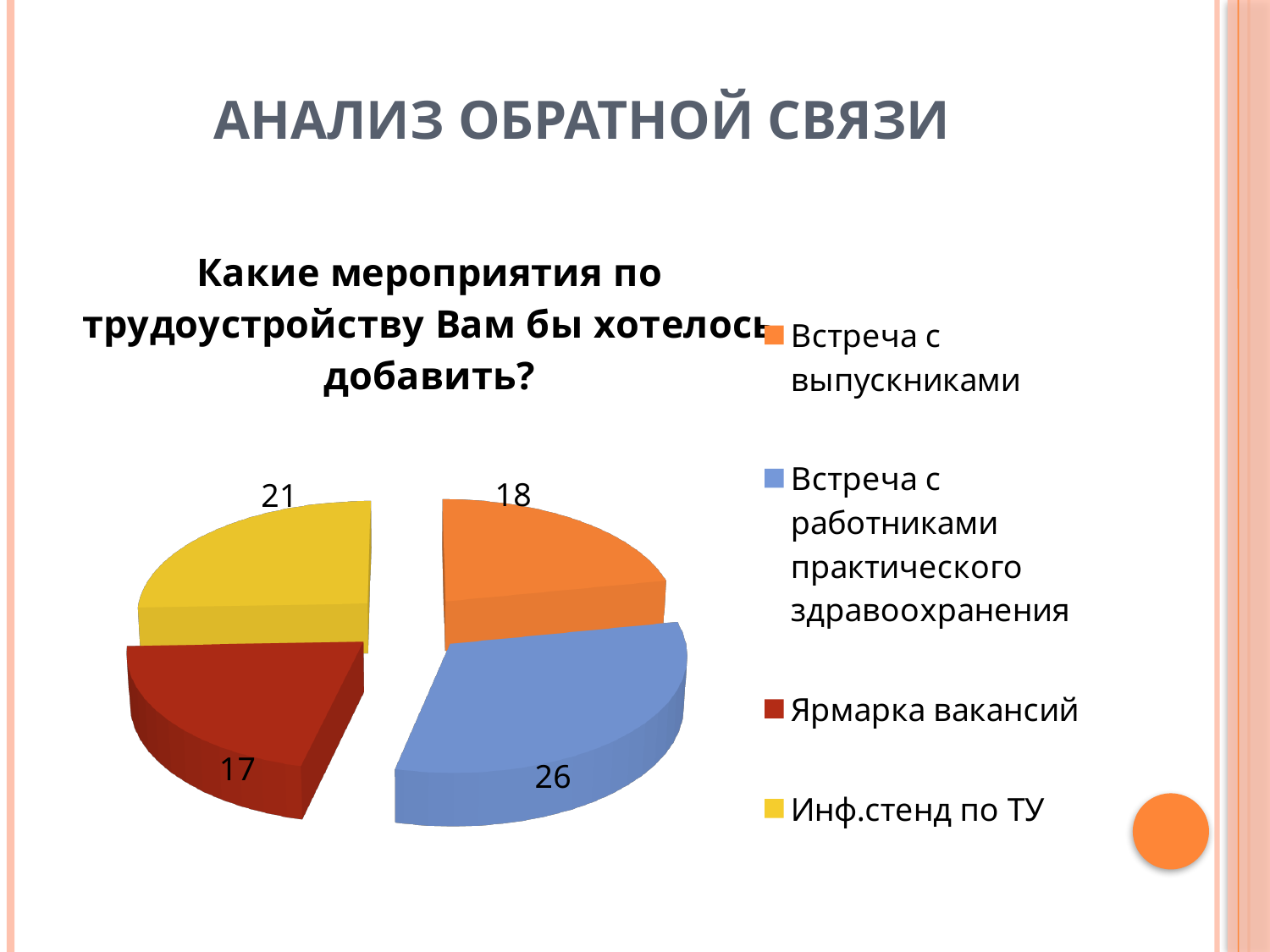
What is the value for Встреча с выпускниками? 18 What type of chart is shown on the slide? pie chart What is the chart's title? Какие мероприятия по трудоустройству Вам бы хотелось добавить? Which category has the highest value? Встреча с работниками практического здравоохранения What is the value for Ярмарка вакансий? 17 What is the value for Встреча с работниками практического здравоохранения? 26 Which category has the lowest value? Ярмарка вакансий How many slices does the pie chart have? 4 What is the value for Инф.стенд по ТУ? 21 Which is larger, the value for Встреча с выпускниками or the value for Инф.стенд по ТУ? Инф.стенд по ТУ What is the difference between the values for Встреча с работниками практического здравоохранения and Инф.стенд по ТУ? 5 How many entries does the legend list? 4